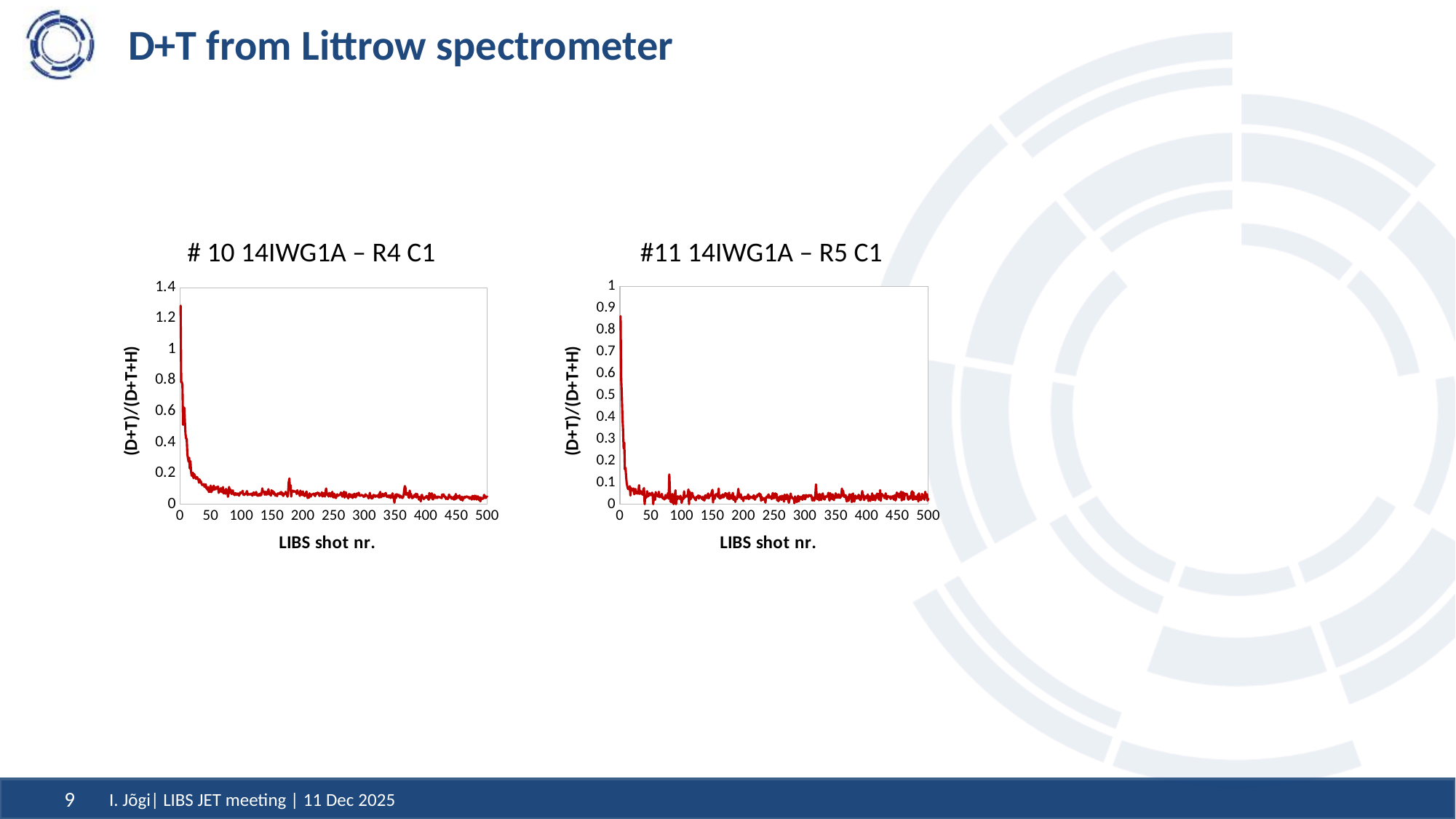
What is the x-axis label of the left chart "# 10 14IWG1A – R4 C1"? LIBS shot nr. In the right chart "#11 14IWG1A – R5 C1", do the values rise or fall as the LIBS shot number increases? fall What kind of chart is the right chart titled "#11 14IWG1A – R5 C1"? line chart In the left chart "# 10 14IWG1A – R4 C1", is the value at LIBS shot 0 greater or less than 1? greater In the left chart "# 10 14IWG1A – R4 C1", do the values rise or fall as the LIBS shot number increases? fall What is the y-axis label of the right chart "#11 14IWG1A – R5 C1"? (D+T)/(D+T+H) In the right chart "#11 14IWG1A – R5 C1", is the value at LIBS shot 300 greater or less than 0.2? less In the right chart "#11 14IWG1A – R5 C1", is the value at LIBS shot 0 larger or smaller than the value at LIBS shot 450? larger In the left chart "# 10 14IWG1A – R4 C1", is the value at LIBS shot 0 larger or smaller than the value at LIBS shot 250? larger What kind of chart is the left chart titled "# 10 14IWG1A – R4 C1"? line chart In the right chart "#11 14IWG1A – R5 C1", is the value at LIBS shot 0 greater or less than 0.5? greater